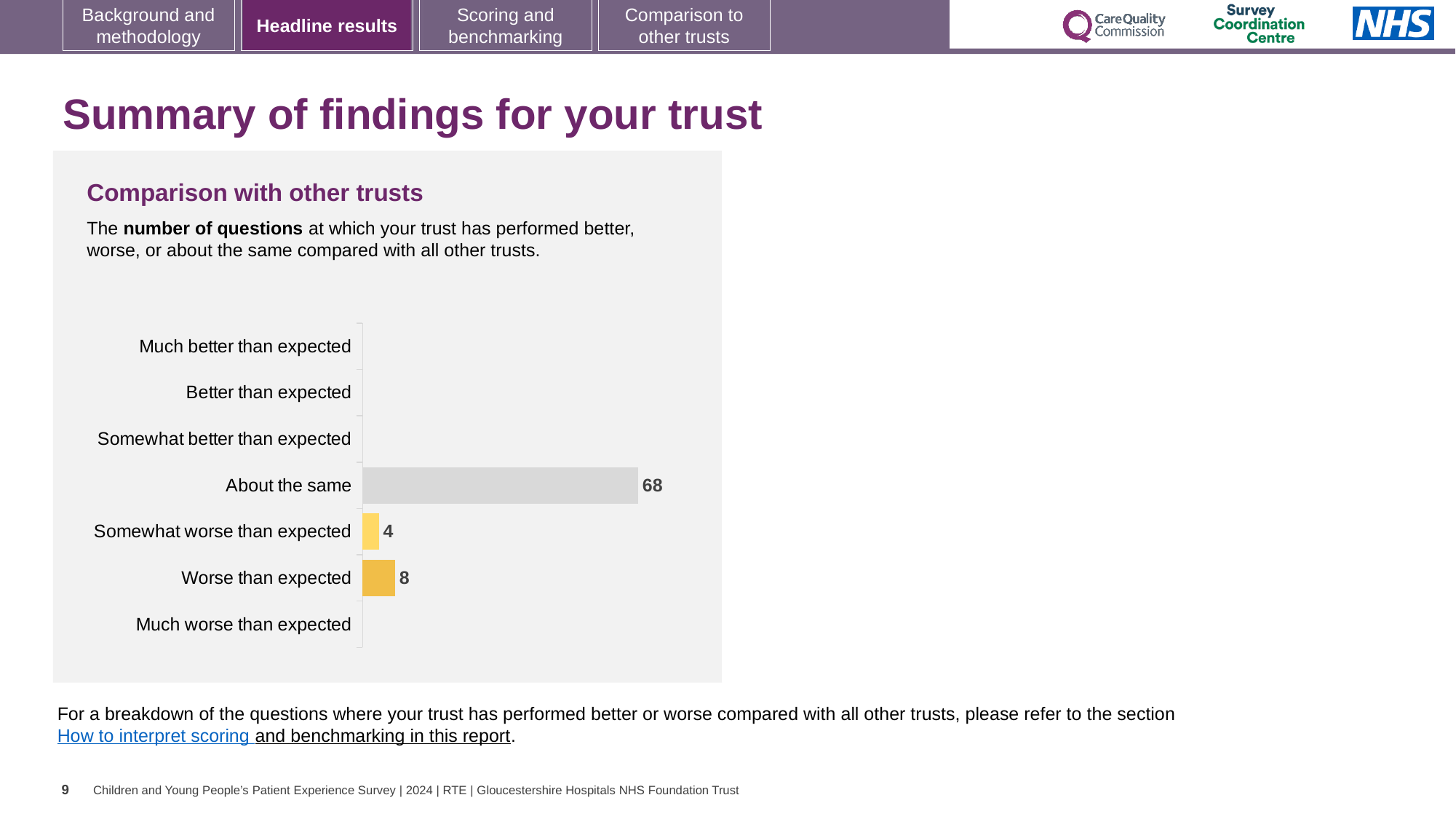
What colour is the bar for 'About the same'? Grey What kind of chart is shown on the slide? Bar chart What is the value for 'Somewhat worse than expected'? 4 What is the difference between the number of questions 'About the same' and 'Worse than expected'? 60 What is the total number of questions across the 'About the same', 'Somewhat worse than expected' and 'Worse than expected' categories? 80 How many categories are listed on the chart's vertical axis? 7 Which is larger, the value for 'Worse than expected' or 'Somewhat worse than expected'? Worse than expected Which category has the highest number of questions? About the same What is the title of the chart section? Comparison with other trusts How many questions are in the 'About the same' category? 68 What is the value for 'Worse than expected'? 8 What is the difference between 'Worse than expected' and 'Somewhat worse than expected'? 4